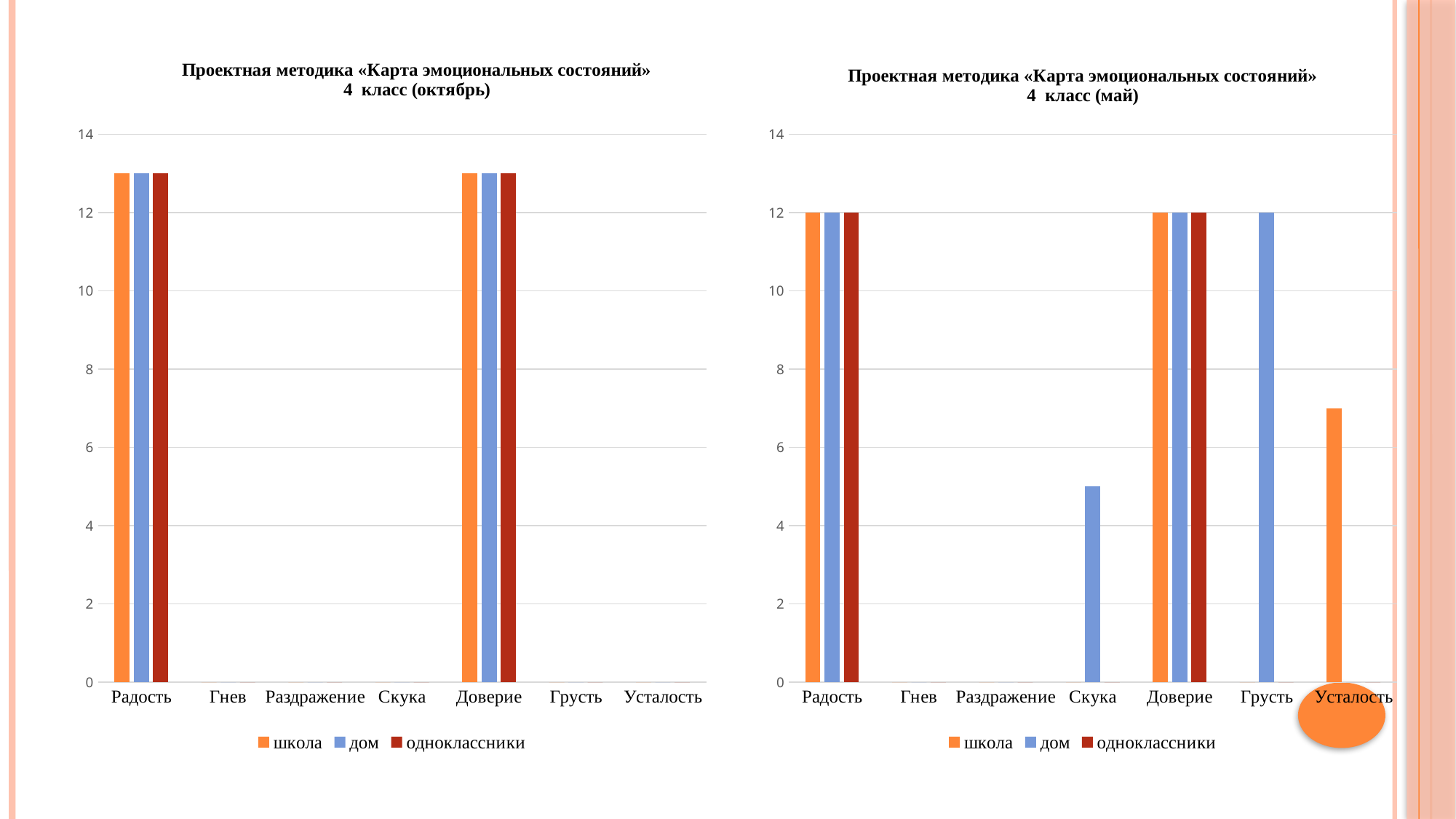
In the right chart, «4 класс (май)», what is the value for одноклассники in the Доверие category? 12 In the right chart, «4 класс (май)», which series has a non-zero bar in the Усталость category? школа In the right chart, «4 класс (май)», is the value for школа in the Усталость category greater or less than 6? greater In the right chart, «4 класс (май)», what is the value for школа in the Радость category? 12 In the left chart, «4 класс (октябрь)», is the value for школа in the Радость category greater or less than 12? greater How many categories are shown on the x axis of the left chart, «4 класс (октябрь)»? 7 In the right chart, «4 класс (май)», is the value for дом in the Скука category greater or less than 6? less In the right chart, «4 класс (май)», which is larger: the дом value for Скука or the дом value for Грусть? Грусть In the right chart, «4 класс (май)», what is the value for дом in the Грусть category? 12 How many series does the legend of the right chart, «4 класс (май)», list? 3 What kind of chart is the left chart, «4 класс (октябрь)»? bar chart What colour represents the одноклассники series in the legend of the left chart, «4 класс (октябрь)»? dark red